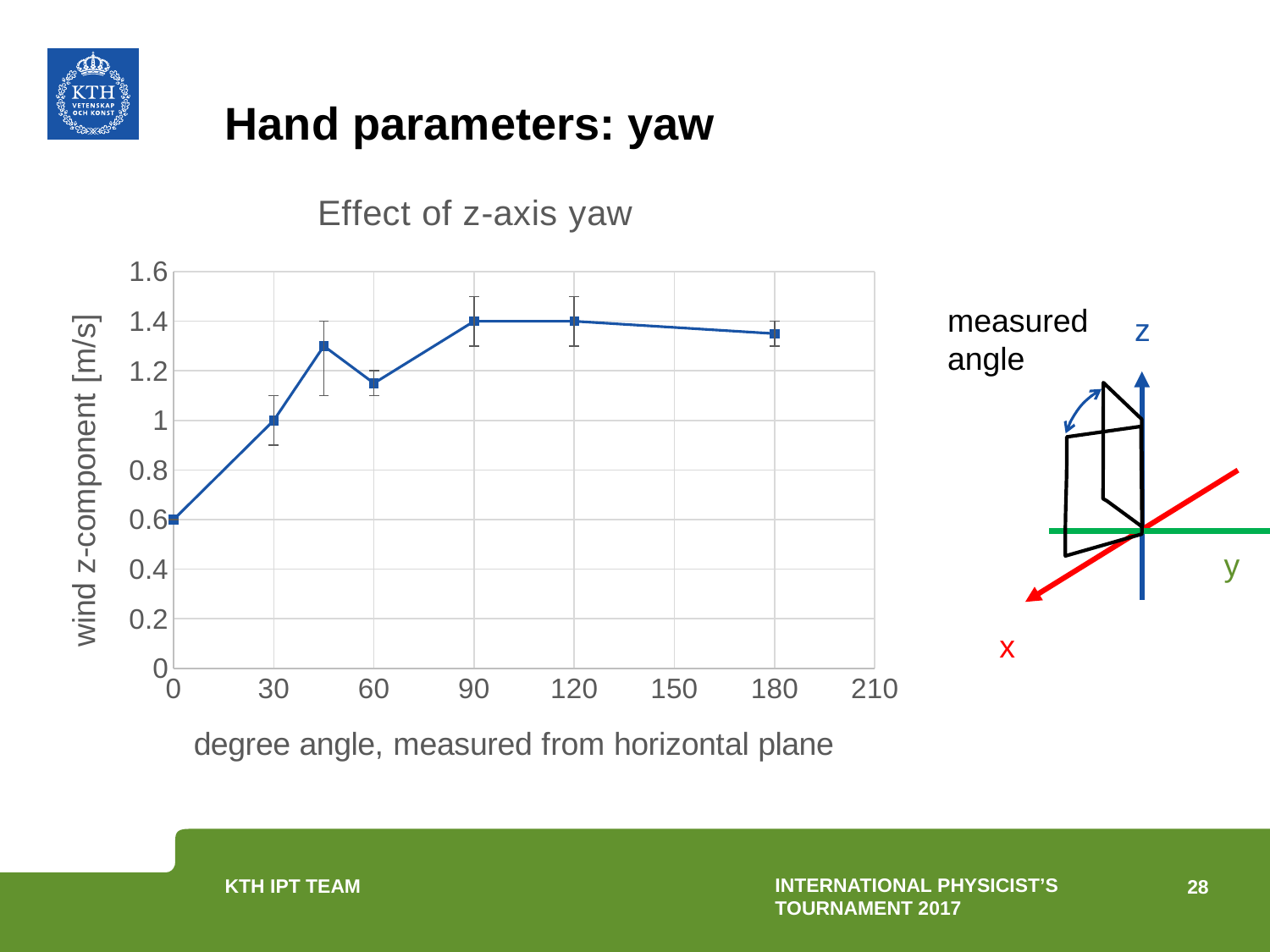
What is the label of the y axis of the chart? wind z-component [m/s] What type of chart is shown on the slide? line chart Is the wind z-component at 60 degrees greater or less than 1.2? less What is the wind z-component at an angle of 90 degrees? 1.4 Is the wind z-component at 45 degrees greater or less than 1.2? greater What is the wind z-component at an angle of 30 degrees? 1 What is the title of the chart? Effect of z-axis yaw How many data points are plotted on the chart? 7 What is the difference in wind z-component between 30 degrees and 0 degrees? 0.4 Which has a larger wind z-component, 0 degrees or 30 degrees? 30 degrees At which angle is the wind z-component lowest? 0 What is the wind z-component at an angle of 0 degrees? 0.6